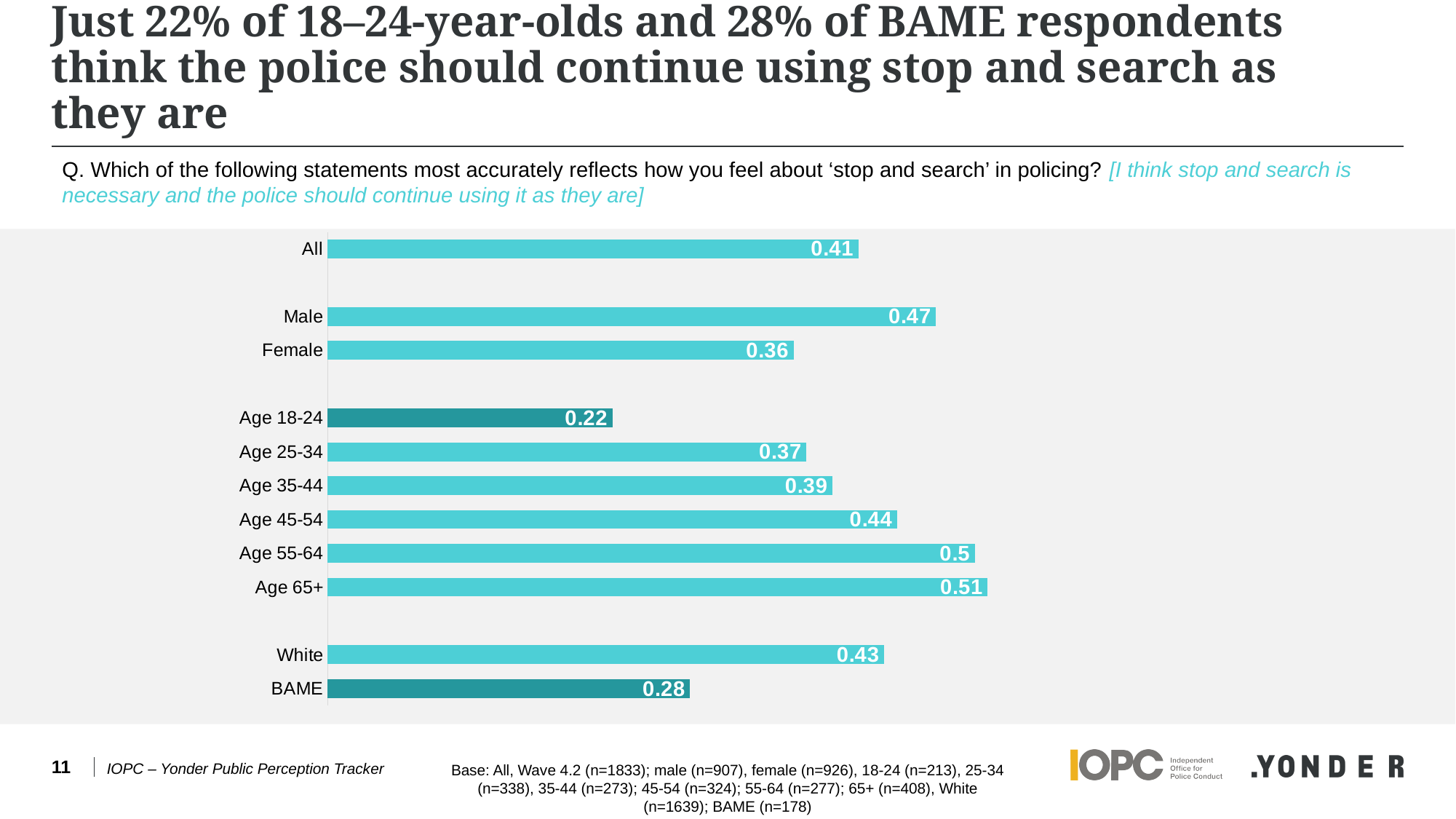
Which category has the highest value? Age 65+ What is the value for All respondents? 0.41 What kind of chart is shown on the slide? Bar chart What is the value for Age 18-24? 0.22 Which category has the lowest value? Age 18-24 How many categories are plotted in the chart? 12 Which two bars are shown in a darker shade of teal than the others? Age 18-24 and BAME What is the difference between the values for Male and Female? 0.11 Do the values rise or fall across the age groups from Age 18-24 to Age 65+? Rise What is the difference between the values for White and BAME? 0.15 Which is larger, the value for Age 25-34 or Age 45-54? Age 45-54 What is the value for BAME respondents? 0.28